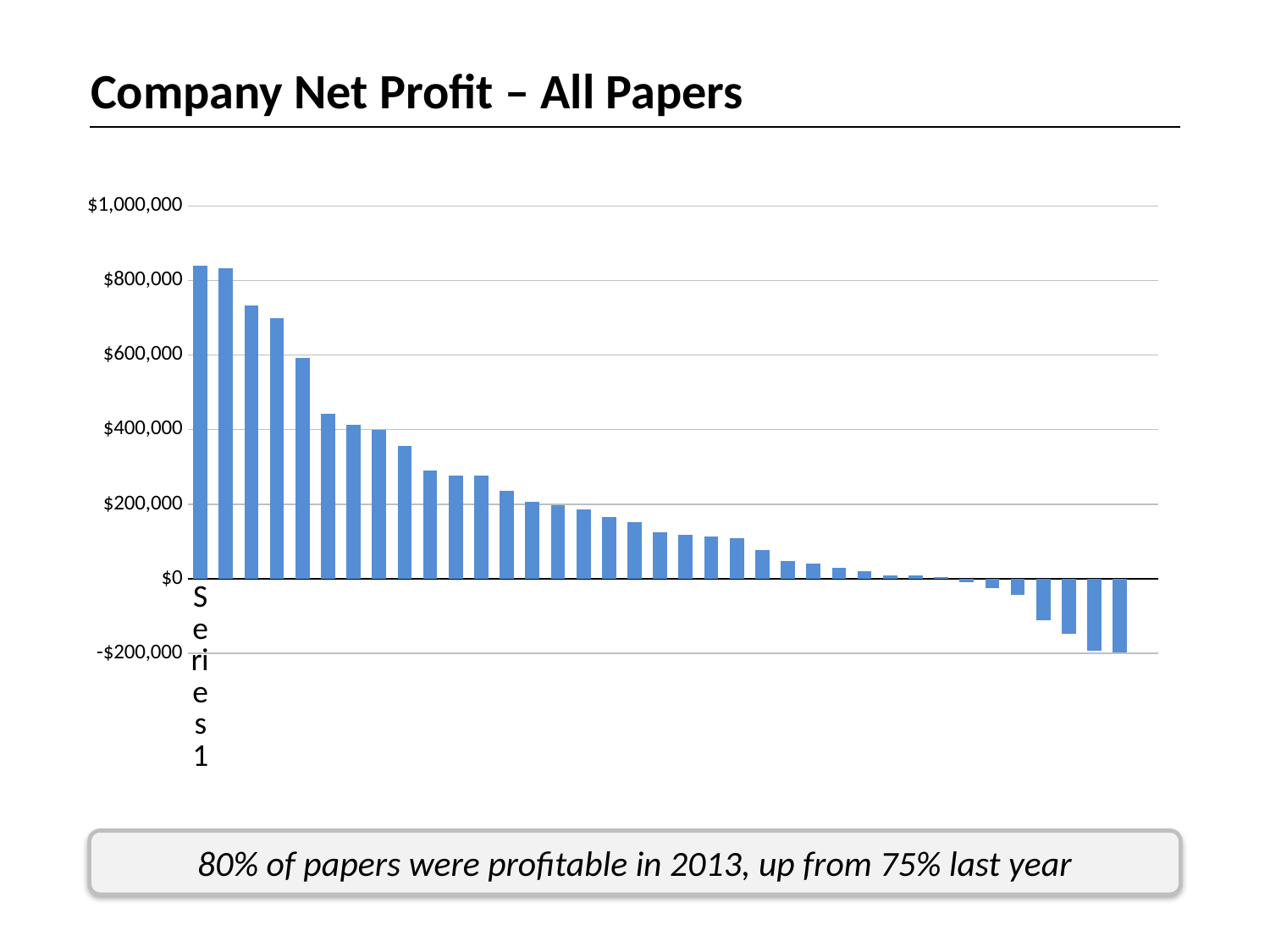
Is the value of the sixth bar from the left greater or less than $400,000? greater Are any of the bars in the chart below $0? yes Is the value of the rightmost bar greater or less than $0? less Do the bar values rise or fall from left to right across the chart? fall What is the highest value shown on the vertical axis? $1,000,000 Is the value of the leftmost bar greater or less than $800,000? greater What is the title of the chart? Company Net Profit – All Papers Which is taller, the third bar from the left or the tenth bar from the left? the third bar from the left What kind of chart is shown on the slide? bar chart